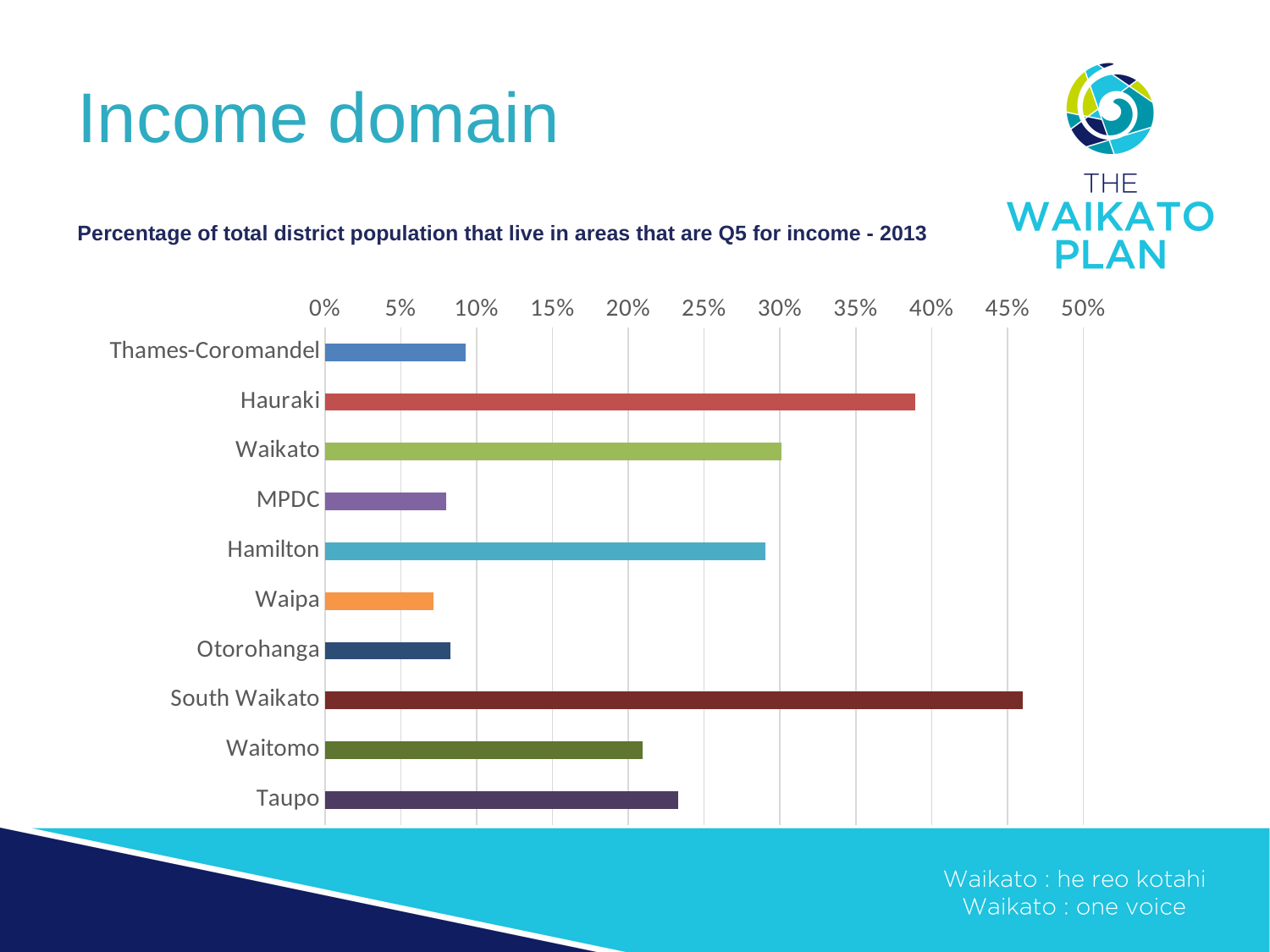
Is the value for Taupo greater or less than 20%? greater How many districts are plotted in the chart? 10 Which has a higher value, Hauraki or Waikato? Hauraki Is the value for Hauraki greater or less than 35%? greater What kind of chart is shown on the slide? Bar chart Is the value for South Waikato greater or less than 45%? greater What is the title of the chart? Percentage of total district population that live in areas that are Q5 for income - 2013 Which has a higher value, Hamilton or Taupo? Hamilton Which district has the highest percentage of population living in Q5 income areas? South Waikato